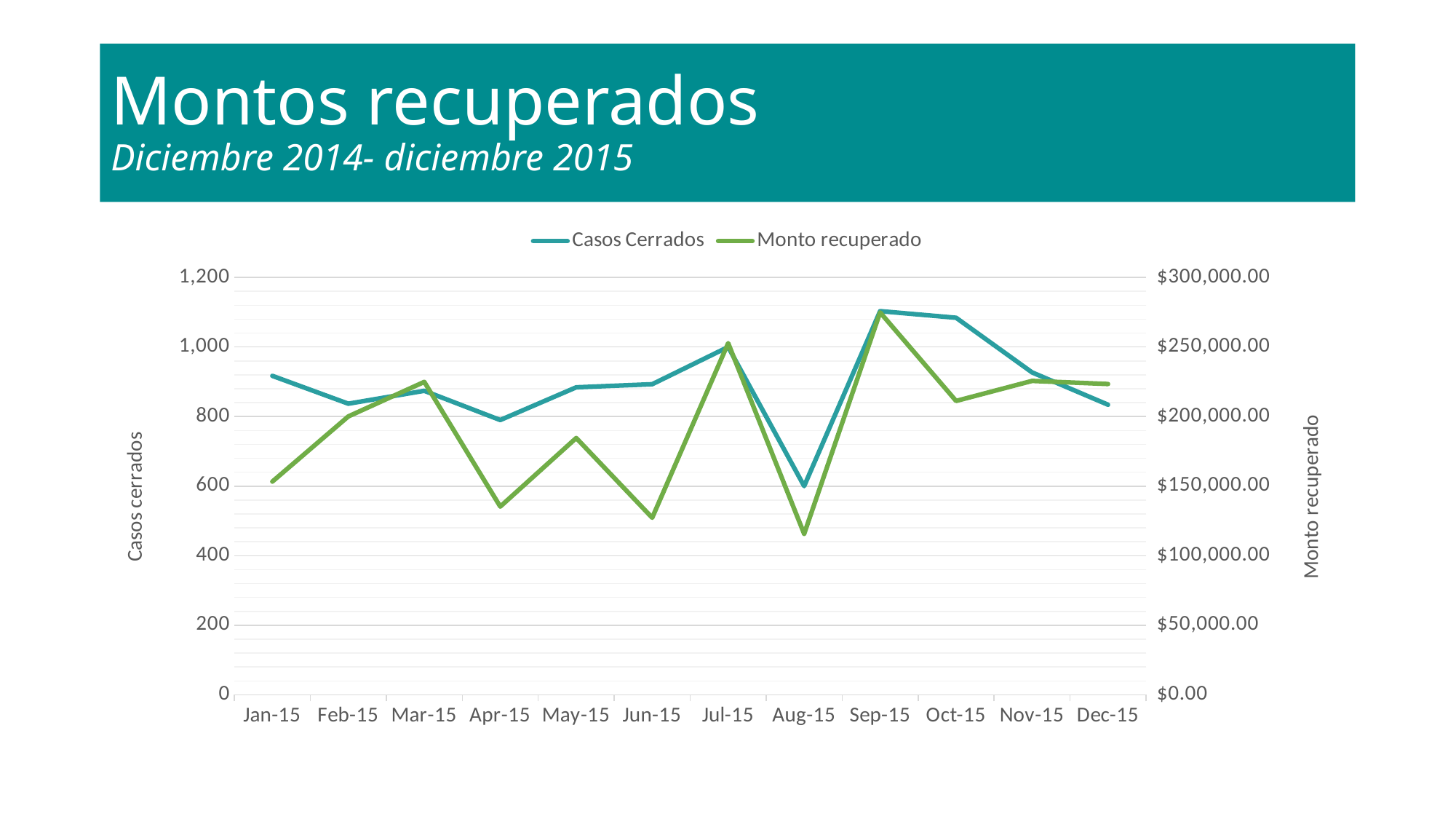
In which month is the Monto recuperado value lowest? Aug-15 Is the Monto recuperado value for Sep-15 greater or less than $250,000.00? greater How many months are plotted along the x axis? 12 Does the Casos Cerrados line rise or fall from Sep-15 to Dec-15? Fall What kind of chart is shown on the slide? Line chart Is the Casos Cerrados value for Aug-15 greater or less than 800? less How many series does the legend list? 2 In which month is the Casos Cerrados value highest? Sep-15 What is the title of the right-hand vertical axis? Monto recuperado In which month is the Casos Cerrados value lowest? Aug-15 Which month has the larger Casos Cerrados value, Jul-15 or Aug-15? Jul-15 In which month is the Monto recuperado value highest? Sep-15